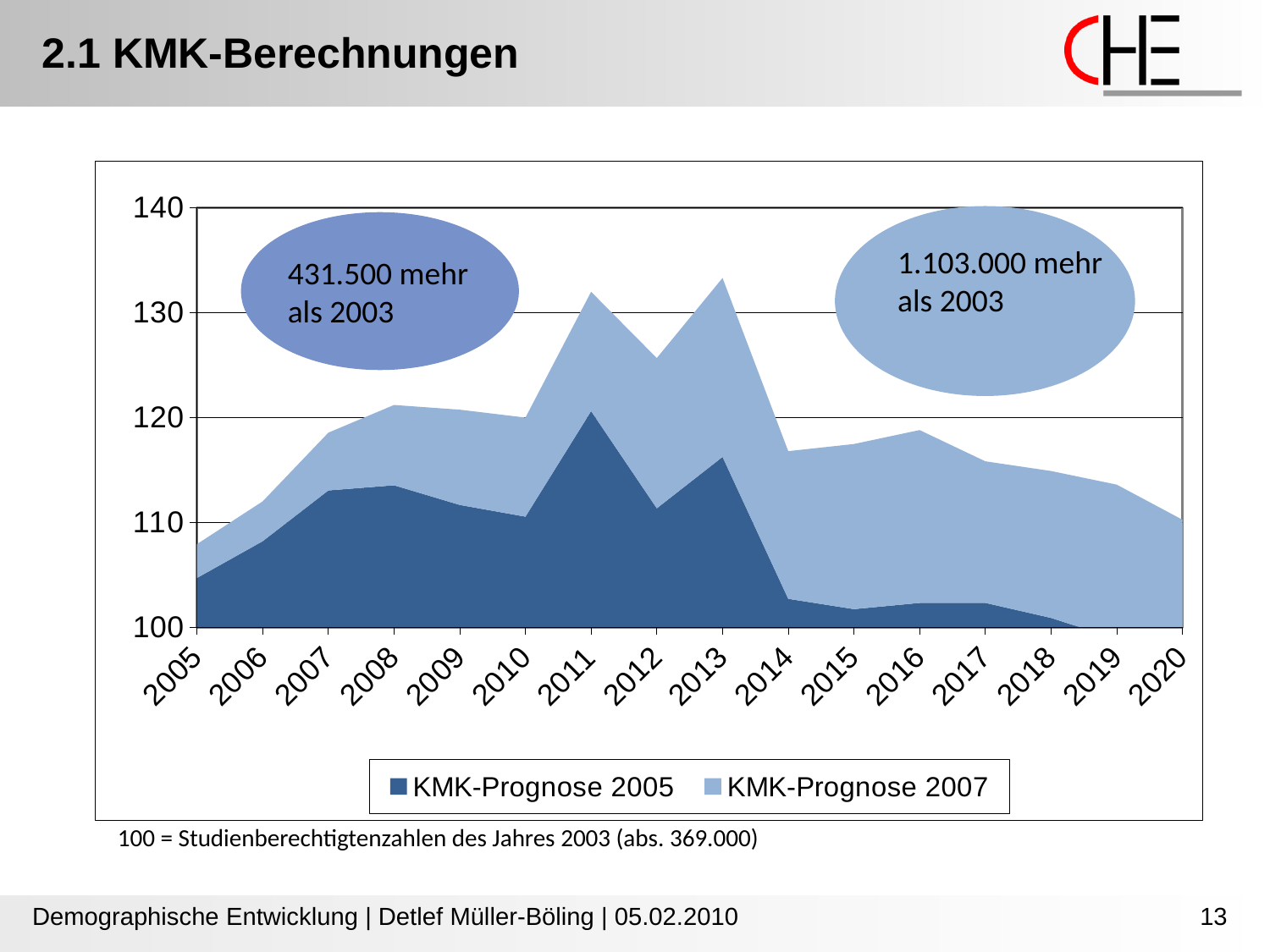
Is the value for KMK-Prognose 2005 in 2008 greater or less than 110? greater How many years are shown on the x axis? 16 Is the value for KMK-Prognose 2005 in 2014 greater or less than 110? less Does the value for KMK-Prognose 2007 rise or fall from 2016 to 2020? Fall Is the value for KMK-Prognose 2007 in 2011 greater or less than 130? greater What are the two series named in the legend? KMK-Prognose 2005 and KMK-Prognose 2007 What kind of chart is shown on the slide? Area chart Which year has the highest value for KMK-Prognose 2005? 2011 In 2011, which series has the larger value, KMK-Prognose 2005 or KMK-Prognose 2007? KMK-Prognose 2007 According to the note below the chart, what absolute number corresponds to the index value 100? 369.000 How many series does the legend list? 2